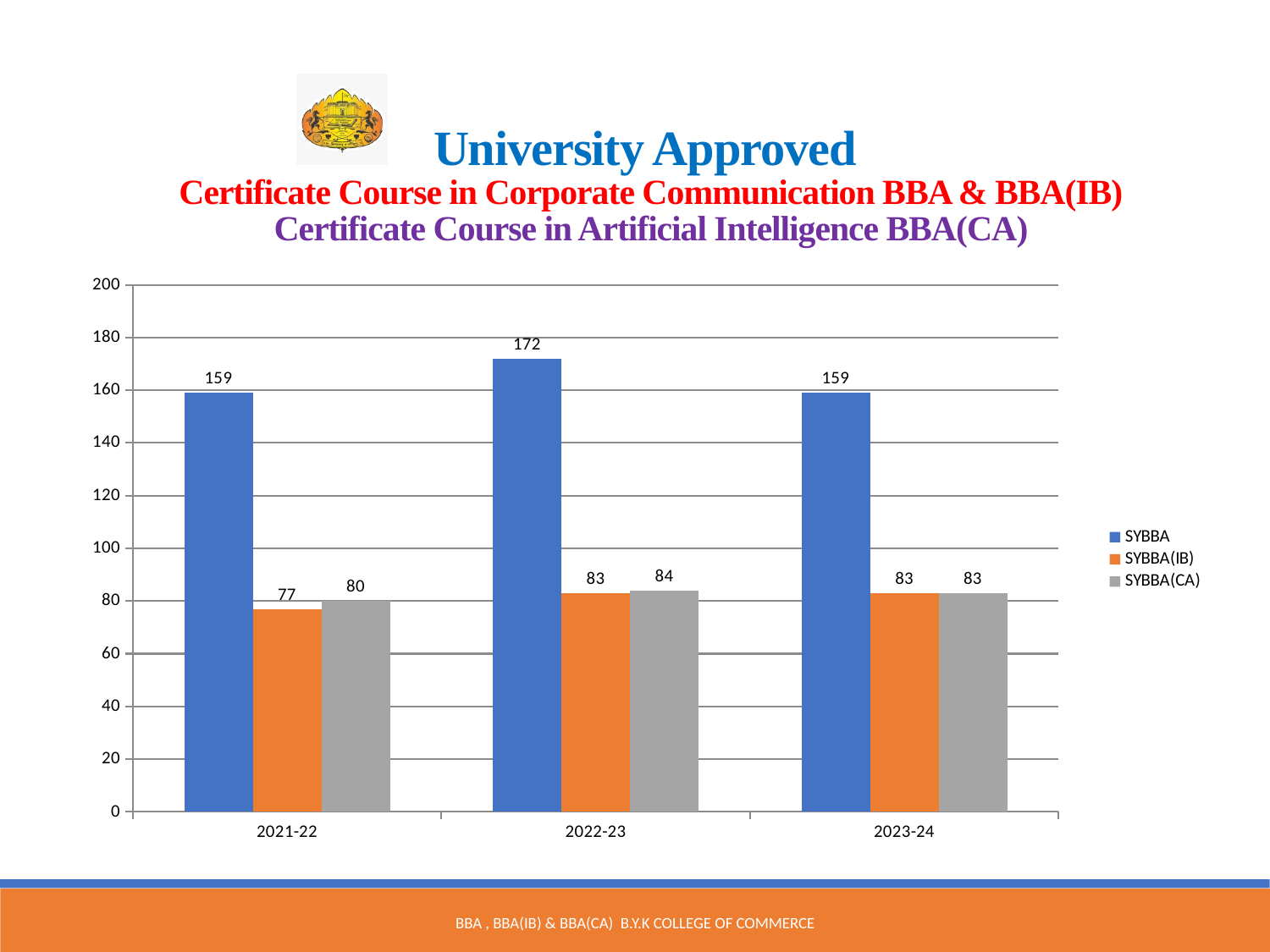
What is the value for SYBBA(CA) in 2023-24? 83 What is the value for SYBBA(IB) in 2021-22? 77 What kind of chart is shown on the slide? bar chart Which colour represents SYBBA(IB) in the chart? orange Is the value for SYBBA in 2023-24 greater or less than 140? greater How many years are shown on the x axis? 3 In which year is the SYBBA value highest? 2022-23 What is the difference between the SYBBA value and the SYBBA(IB) value in 2021-22? 82 Which is larger in 2022-23, SYBBA(IB) or SYBBA(CA)? SYBBA(CA) How many series does the legend list? 3 What is the value for SYBBA in 2022-23? 172 In which year is the SYBBA(IB) value lowest? 2021-22